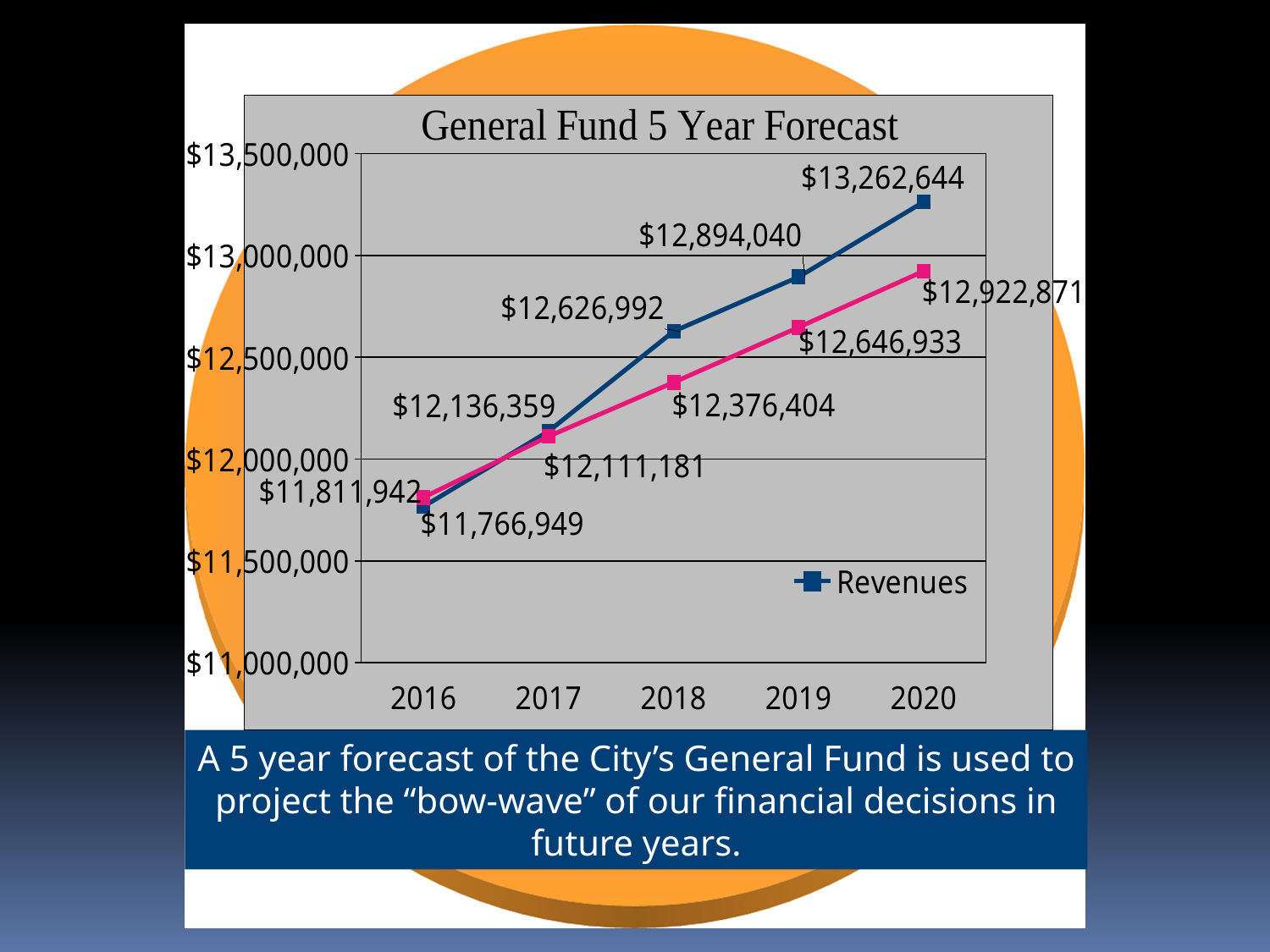
In which year are Revenues highest? 2020 How many years are shown on the x axis? 5 By how much do Revenues in 2020 exceed Revenues in 2016? $1,495,695 What kind of chart is shown on the slide? Line chart What is the Revenues value for 2016? $11,766,949 In which year are Revenues lowest? 2016 How many series does the legend list? 1 Is the Revenues value for 2019 greater or less than $13,000,000? less In 2016, which is larger: the Revenues value or the pink line value? The pink line value What is the difference between the Revenues value and the pink line value in 2020? $339,773 What is the Revenues value for 2020? $13,262,644 What is the value of the pink line in 2018? $12,376,404